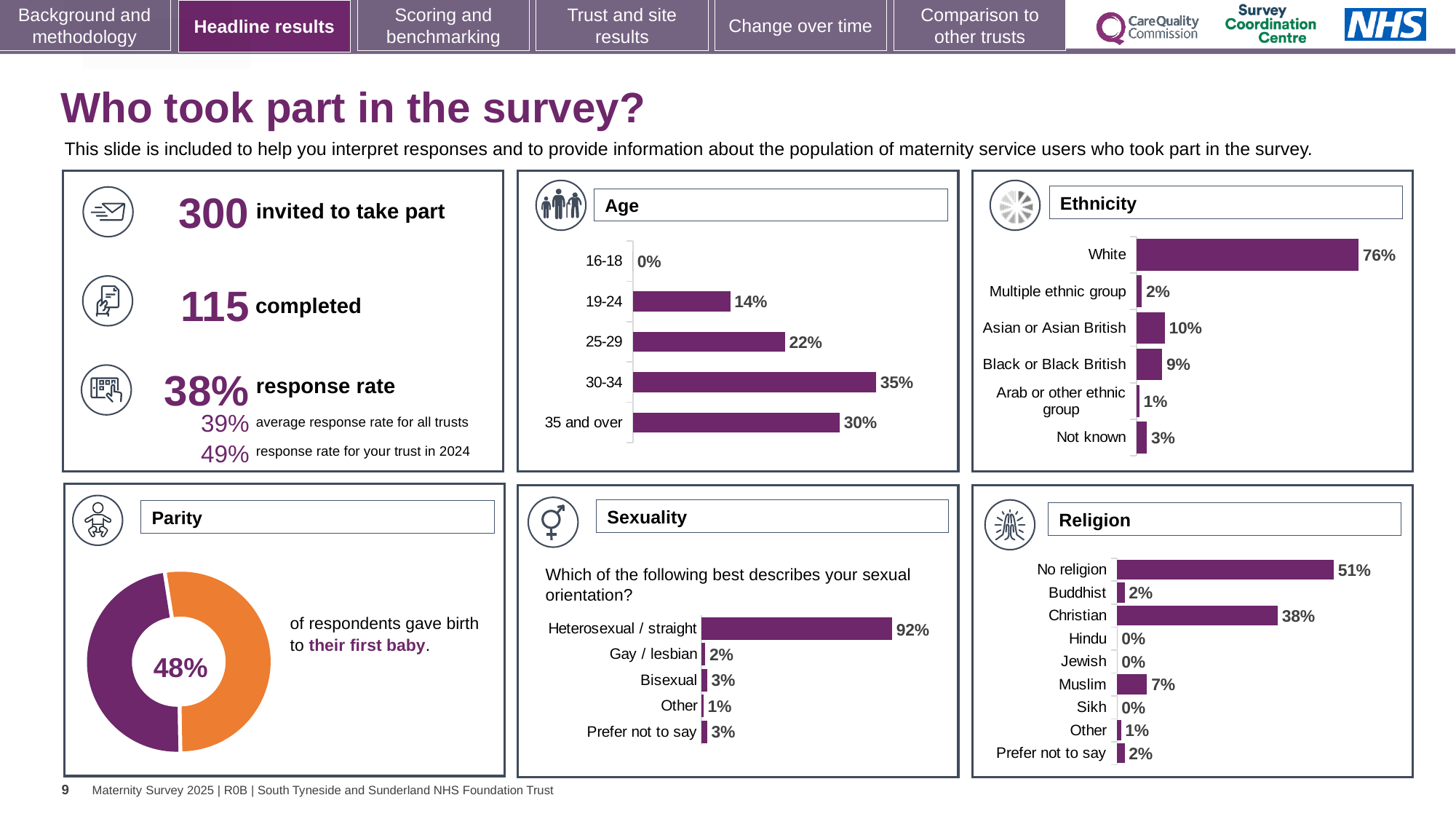
In the Religion chart, which category has the highest percentage? No religion In the Religion chart, what percentage of respondents were Christian? 38% In the Age chart, how many age categories are shown? 5 In the Sexuality chart, what percentage of respondents answered Heterosexual / straight? 92% In the Age chart, what percentage of respondents were aged 30-34? 35% In the Ethnicity chart, what is the difference between Asian or Asian British and Black or Black British? 1% In the Religion chart, how many categories are listed? 9 In the Ethnicity chart, which category has the lowest percentage? Arab or other ethnic group In the Sexuality chart, which is larger: Bisexual or Gay / lesbian? Bisexual What kind of chart is used in the Parity panel? Doughnut chart In the Ethnicity chart, what percentage of respondents were White? 76% In the Age chart, which age group has the highest percentage? 30-34